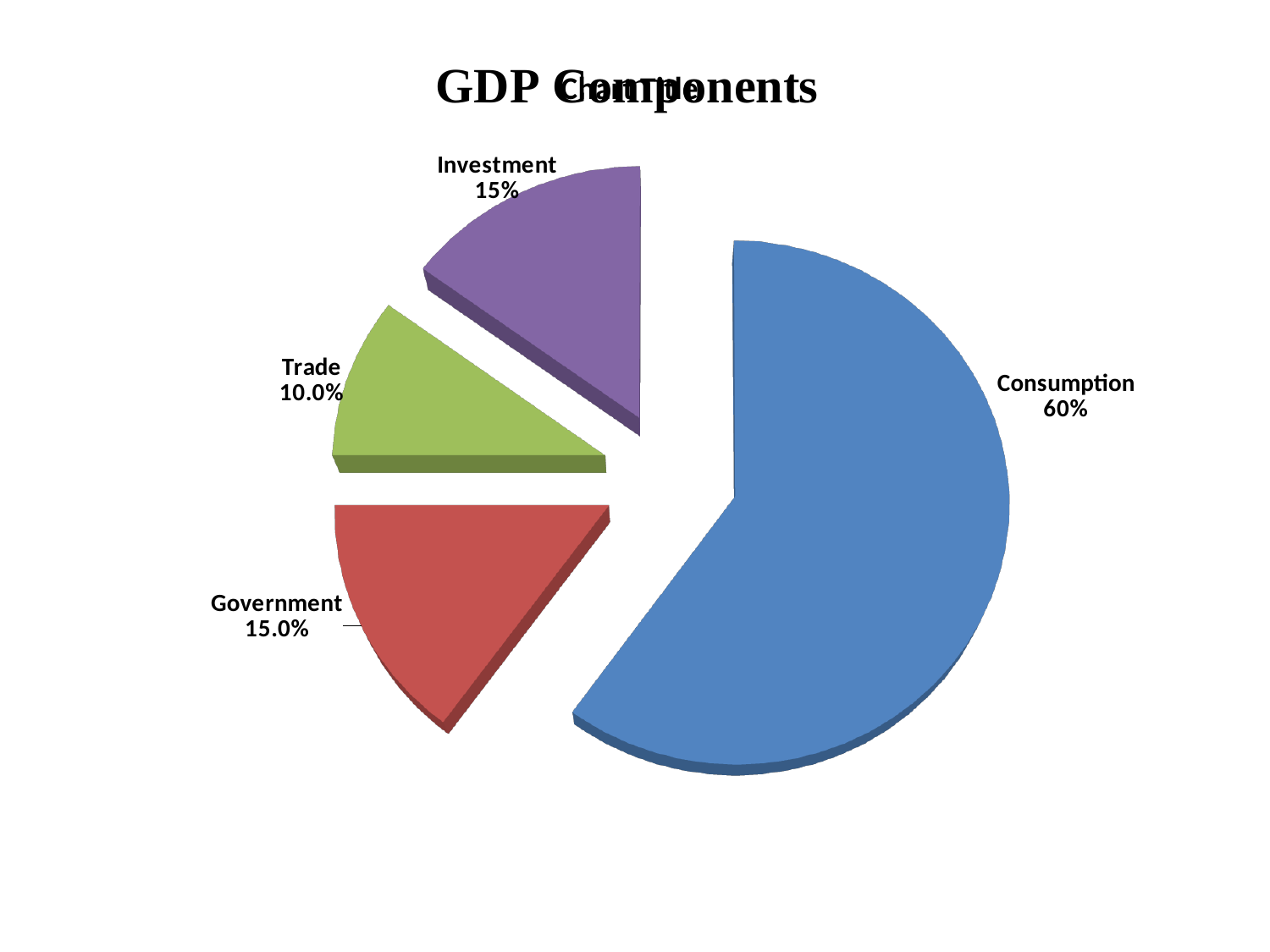
What is the value shown for Trade? 10.0% What colour is the Consumption slice? blue What is the value shown for Government? 15.0% What kind of chart is shown on the slide? pie chart What is the value shown for Investment? 15% By how many percentage points does Consumption exceed Trade? 50 Which component has the smallest slice of the pie? Trade How many slices does the pie chart have? 4 Which component has the largest slice of the pie? Consumption Which is larger, the Consumption slice or the Investment slice? Consumption By how many percentage points does Government exceed Trade? 5 What share of the pie does Consumption have? 60%